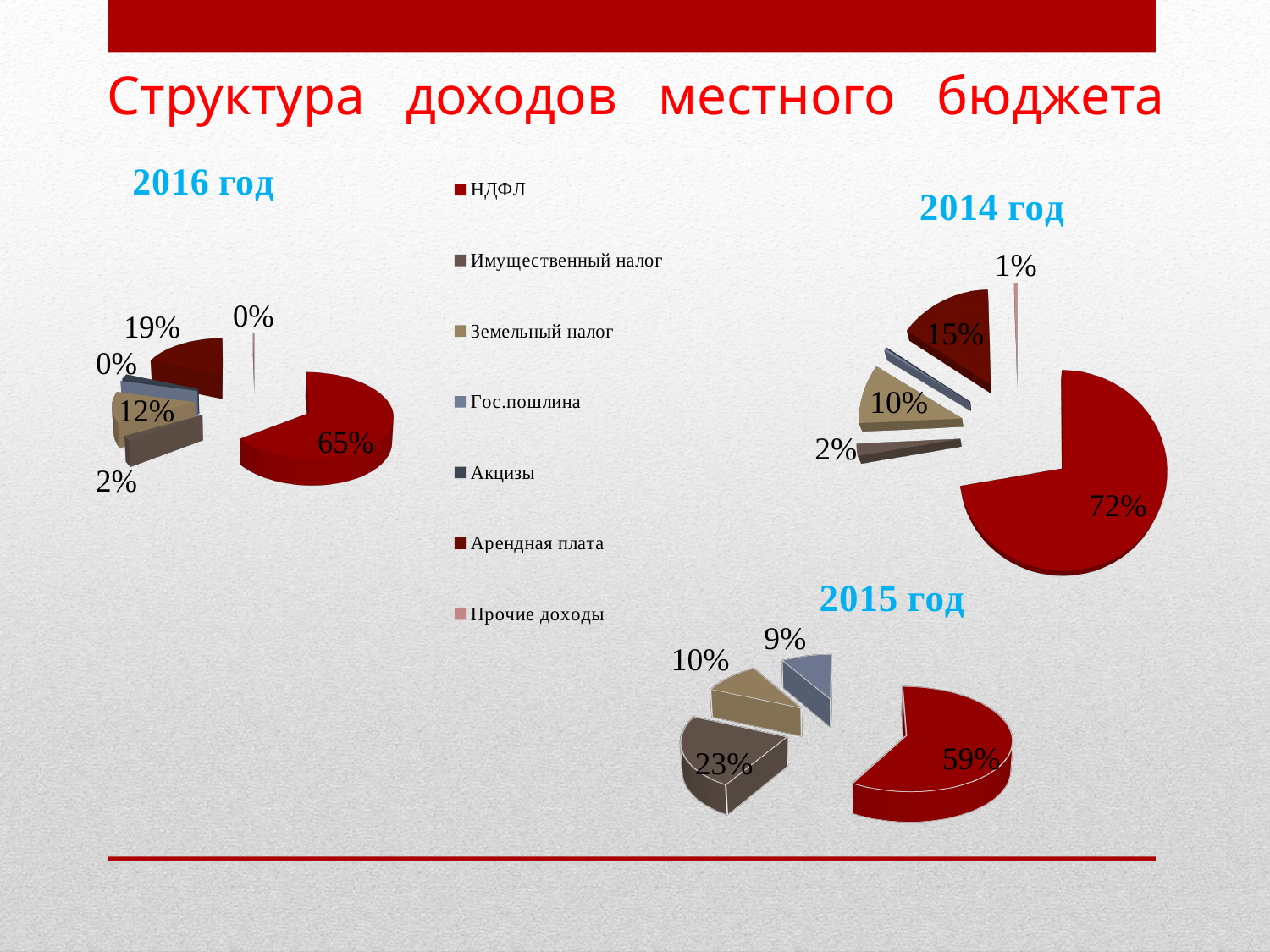
In the 2015 год pie chart, what share does Имущественный налог have? 23% How many categories does the legend list? 7 What is the difference between the НДФЛ share in 2014 год and in 2015 год? 13% In the 2014 год pie chart, what share does Земельный налог have? 10% In the 2014 год pie chart, which category has the largest share? НДФЛ In the 2015 год pie chart, which is larger: Земельный налог or Гос.пошлина? Земельный налог What is the difference between the Арендная плата share in 2016 год and in 2014 год? 4% What type of chart is used for the 2015 год data? Pie chart In the 2014 год pie chart, what share does НДФЛ have? 72% In the 2015 год pie chart, what share does НДФЛ have? 59% In the 2016 год pie chart, what share does Арендная плата have? 19% In the 2016 год pie chart, what share does НДФЛ have? 65%